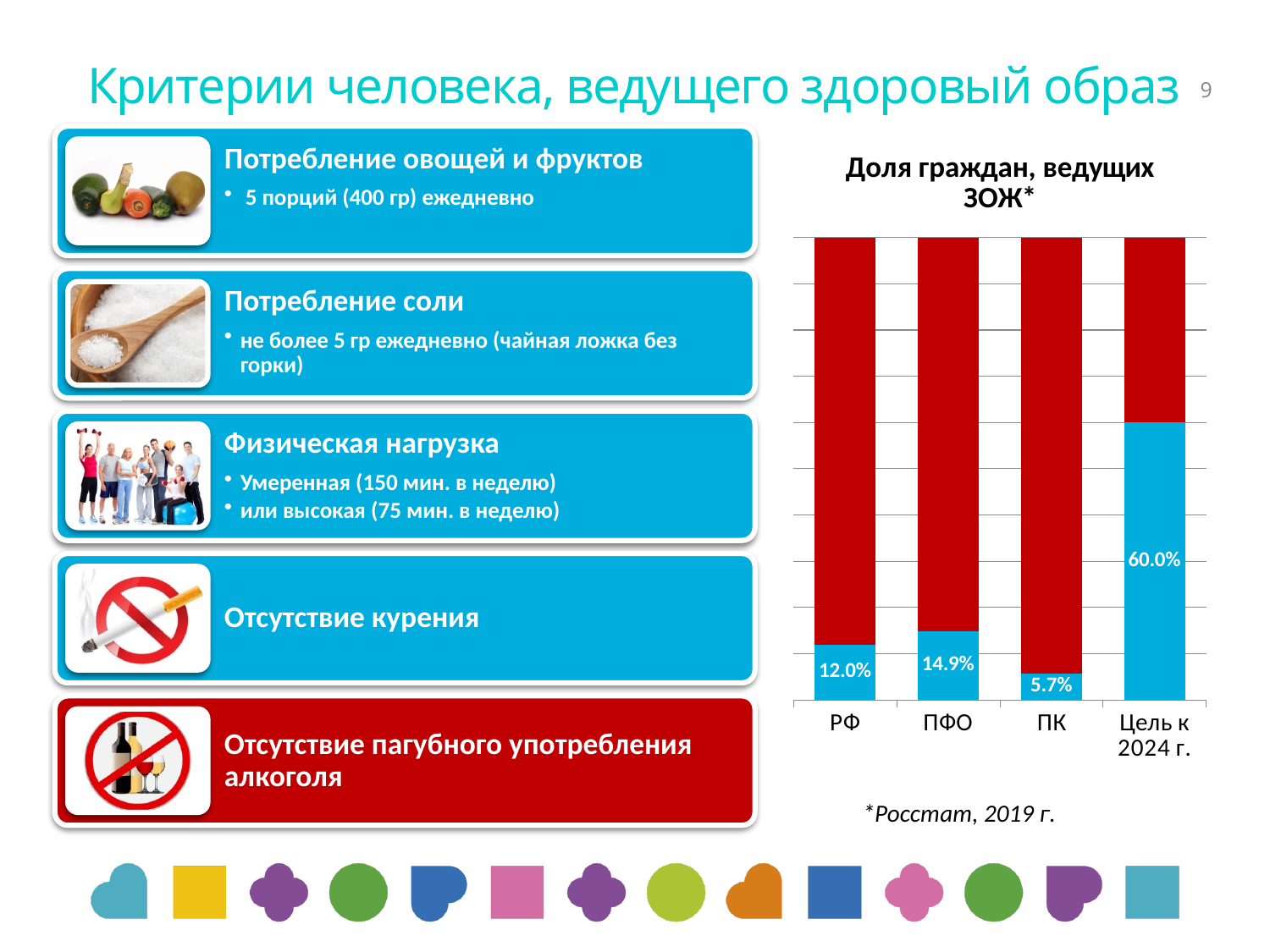
Which category has the highest labelled value in the chart? Цель к 2024 г. What is the value shown for 'Цель к 2024 г.' in the chart? 60.0% What kind of chart is shown on the slide? Bar chart What is the value shown for ПК in the chart? 5.7% What is the value shown for ПФО in the chart? 14.9% What is the value shown for РФ in the chart 'Доля граждан, ведущих ЗОЖ*'? 12.0% What is the title of the chart on the slide? Доля граждан, ведущих ЗОЖ* What is the difference between the value for ПФО and the value for ПК? 9.2% Which category has the lowest labelled value in the chart? ПК How many categories are shown on the x axis of the chart? 4 What is the difference between the value for 'Цель к 2024 г.' and the value for РФ? 48.0% Which is larger, the value for ПФО or the value for РФ? ПФО